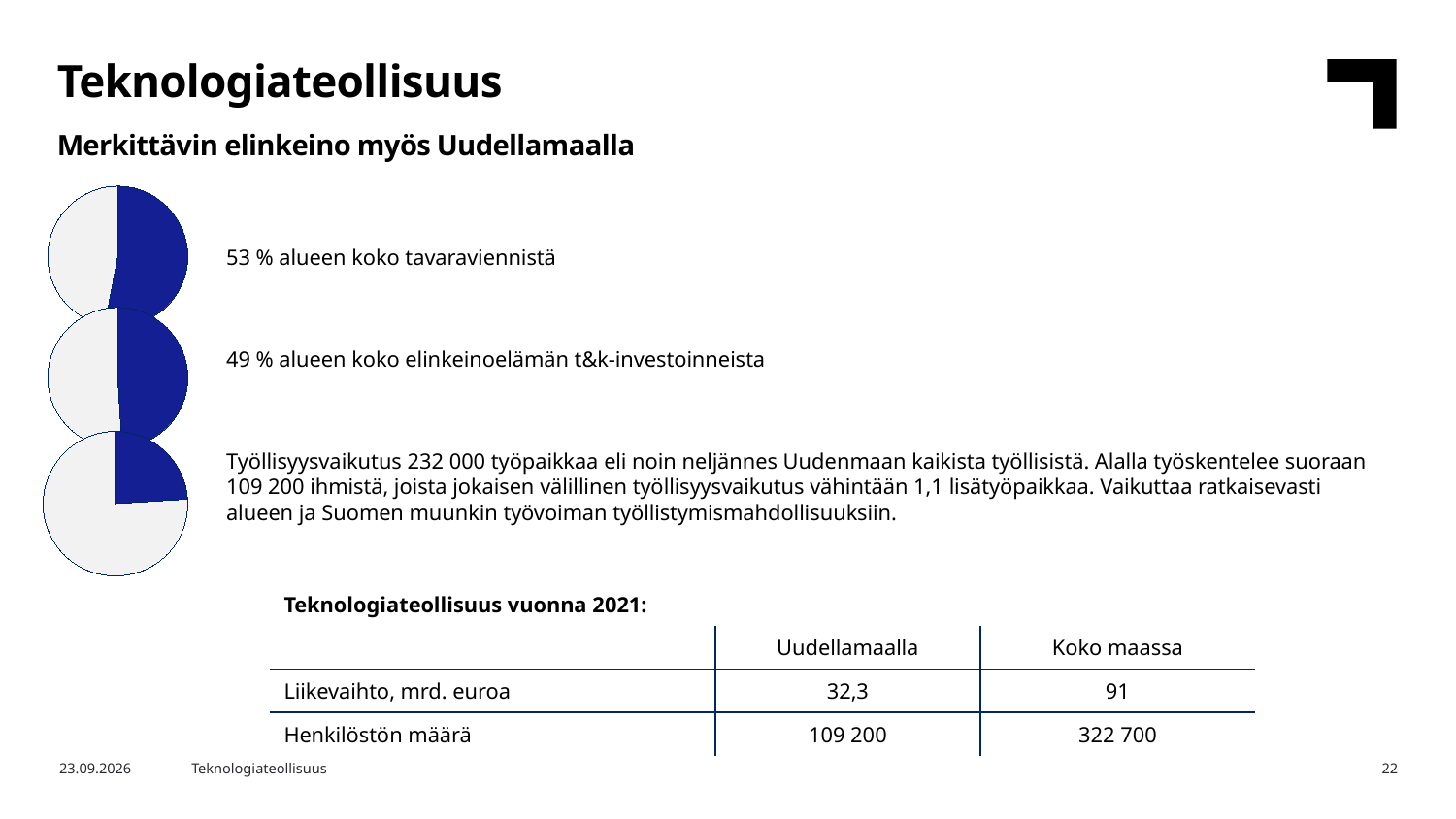
Which pie chart has the largest blue slice: the top, middle or bottom one? Top In the top pie chart, is the blue slice greater or less than 50 % of the pie? greater What does the bottom pie chart illustrate, according to the text next to it? Employment effect: about a quarter of all employed people in Uusimaa In the bottom pie chart, is the blue slice greater or less than 50 % of the pie? less Is the blue slice larger in the top pie chart or in the bottom pie chart? Top pie chart What colour is used for the highlighted slice in each pie chart? Blue How many pie charts are on the slide? 3 What kind of charts are shown on the left side of the slide? Pie charts Which pie chart has the smallest blue slice: the top, middle or bottom one? Bottom In the middle pie chart, what share of the region's business R&D investments (t&k-investoinnit) does the blue slice represent? 49 % In the top pie chart, what share of the region's total goods exports (tavaravienti) does the blue slice represent? 53 % What is the difference in percentage points between the blue share in the top pie chart (53 %) and the middle pie chart (49 %)? 4 percentage points